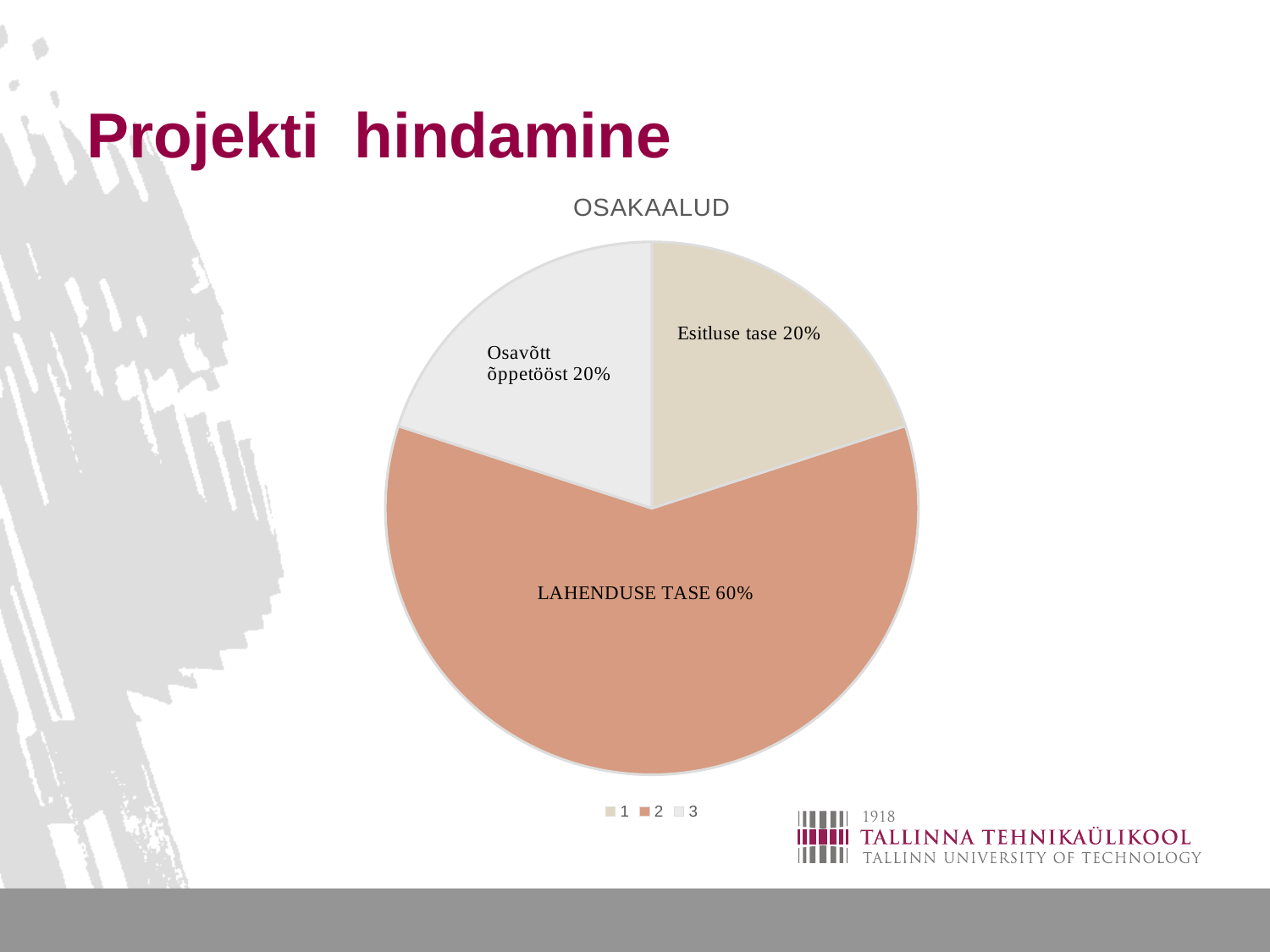
What share of the pie does Esitluse tase take? 20% Is the share for LAHENDUSE TASE greater or less than 50%? greater What share of the pie does LAHENDUSE TASE take? 60% What kind of chart is shown on the slide? pie chart Which slice of the pie is the largest? LAHENDUSE TASE What is the difference between the share for LAHENDUSE TASE and the share for Esitluse tase? 40% What share of the pie does Osavõtt õppetööst take? 20% How many slices does the pie chart have? 3 What is the title of the chart? OSAKAALUD What are the entries listed in the legend? 1, 2, 3 Which is larger, the share for LAHENDUSE TASE or the share for Osavõtt õppetööst? LAHENDUSE TASE How many entries does the legend list? 3